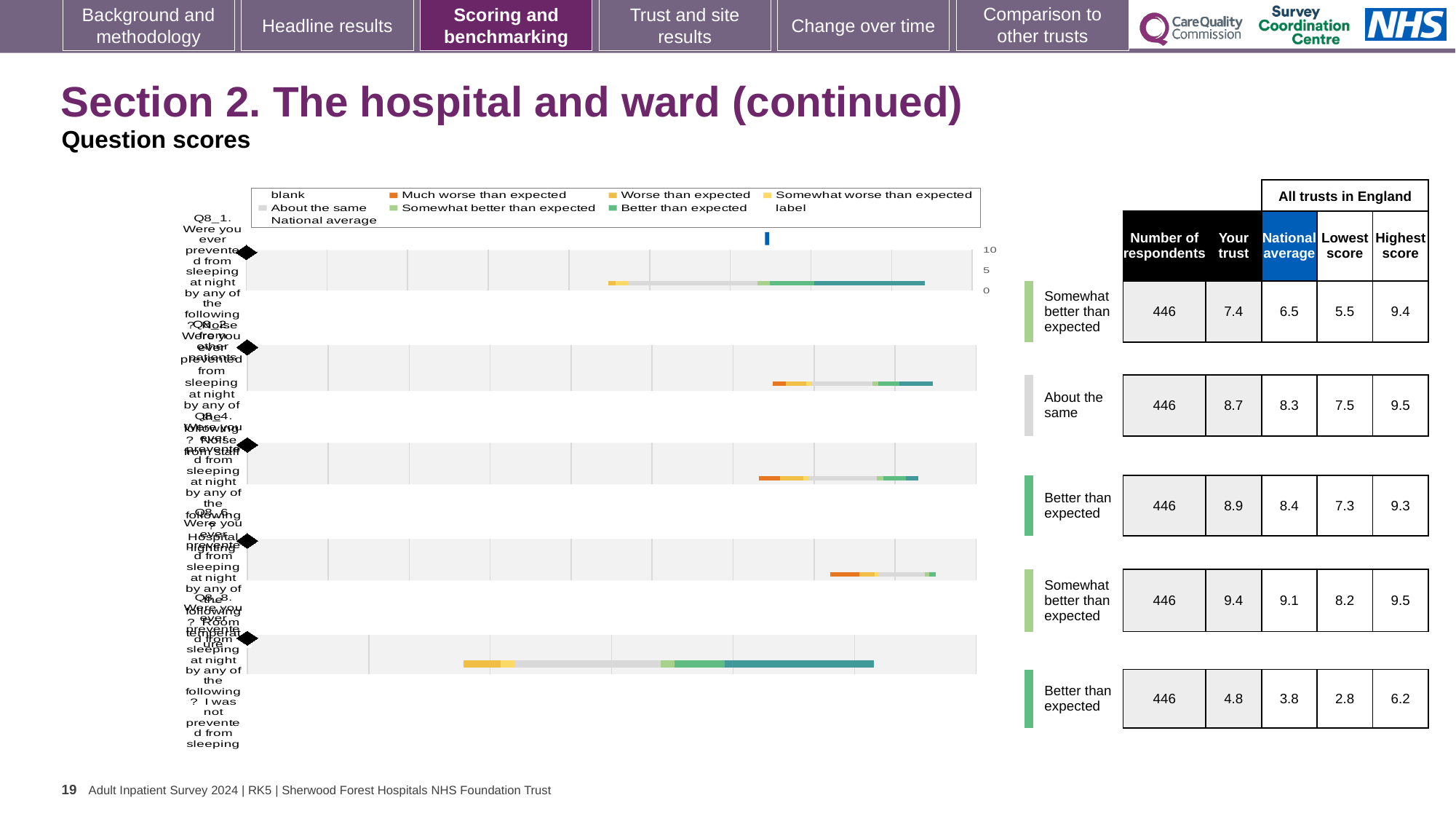
Which row has the lowest 'Your trust' score? the fifth (bottom) row (4.8) What is the 'Your trust' score for the first (top) row of the chart? 7.4 For the first row, which is larger: the 'Your trust' score or the national average? Your trust (7.4) How many question rows (bars) does the chart show? 5 What is the highest score among all trusts in England for the second row? 9.5 How many respondents are listed for the first row? 446 What benchmark category is shown for the bottom row of the chart? Better than expected What is the national average for the last (bottom) row of the chart? 3.8 What kind of chart is shown on the slide? bar chart Which row has the highest 'Your trust' score? the fourth row (9.4) What is the lowest score among all trusts in England for the fourth row? 8.2 For the third row, what is the difference between the 'Your trust' score and the national average? 0.5